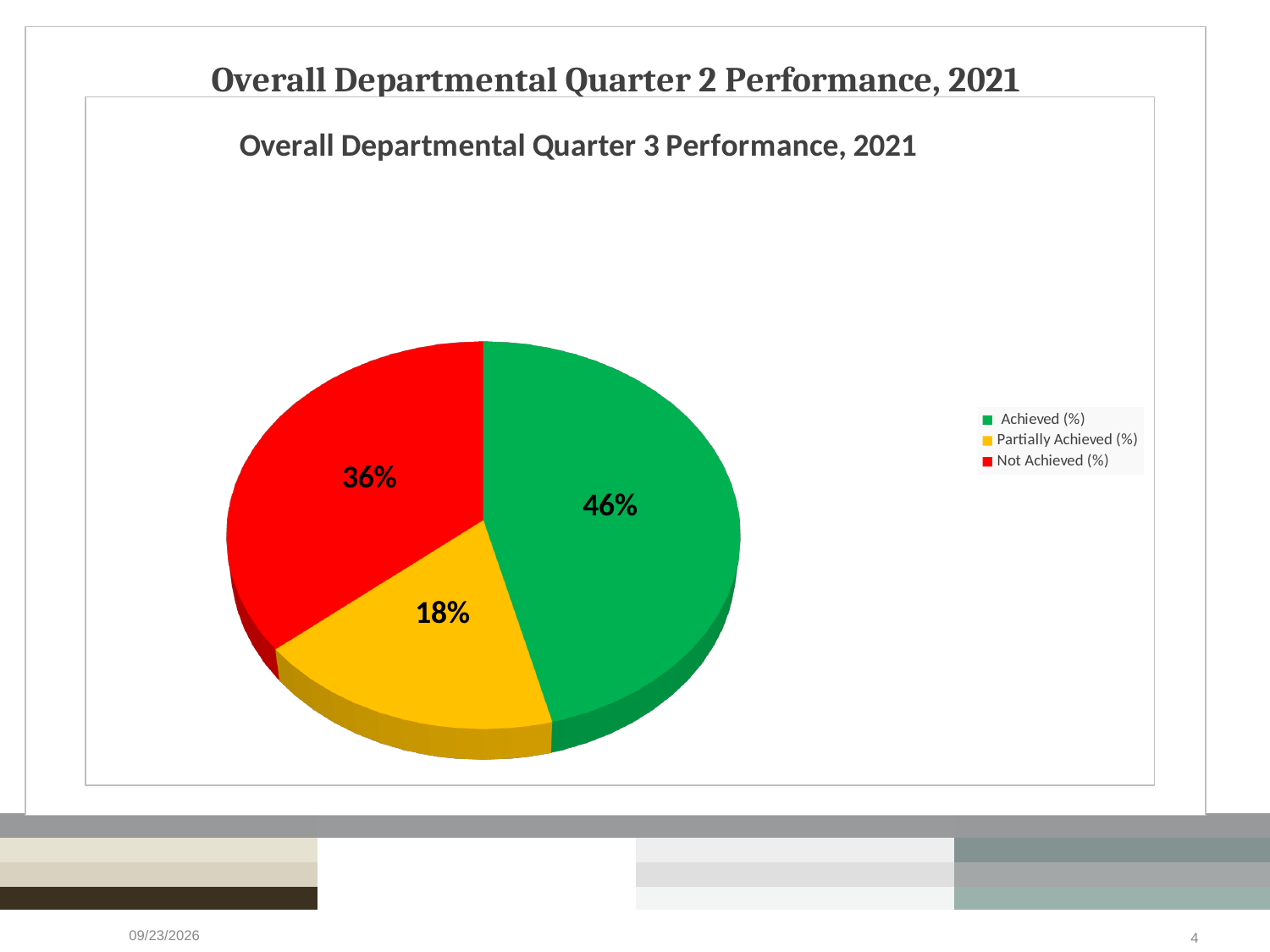
Which category has the largest slice of the pie? Achieved (%) How many slices does the pie chart have? 3 What percentage is shown for Partially Achieved (%)? 18% What kind of chart is shown on the slide? Pie chart What percentage is shown for Not Achieved (%)? 36% What is the chart's title? Overall Departmental Quarter 3 Performance, 2021 What percentage is shown for Achieved (%)? 46% Which is larger, the Not Achieved (%) slice or the Partially Achieved (%) slice? Not Achieved (%) What is the difference between the Not Achieved (%) and Partially Achieved (%) slices? 18% What colour is the Not Achieved (%) slice? Red Which category has the smallest slice of the pie? Partially Achieved (%) What is the difference between the Achieved (%) and Not Achieved (%) slices? 10%